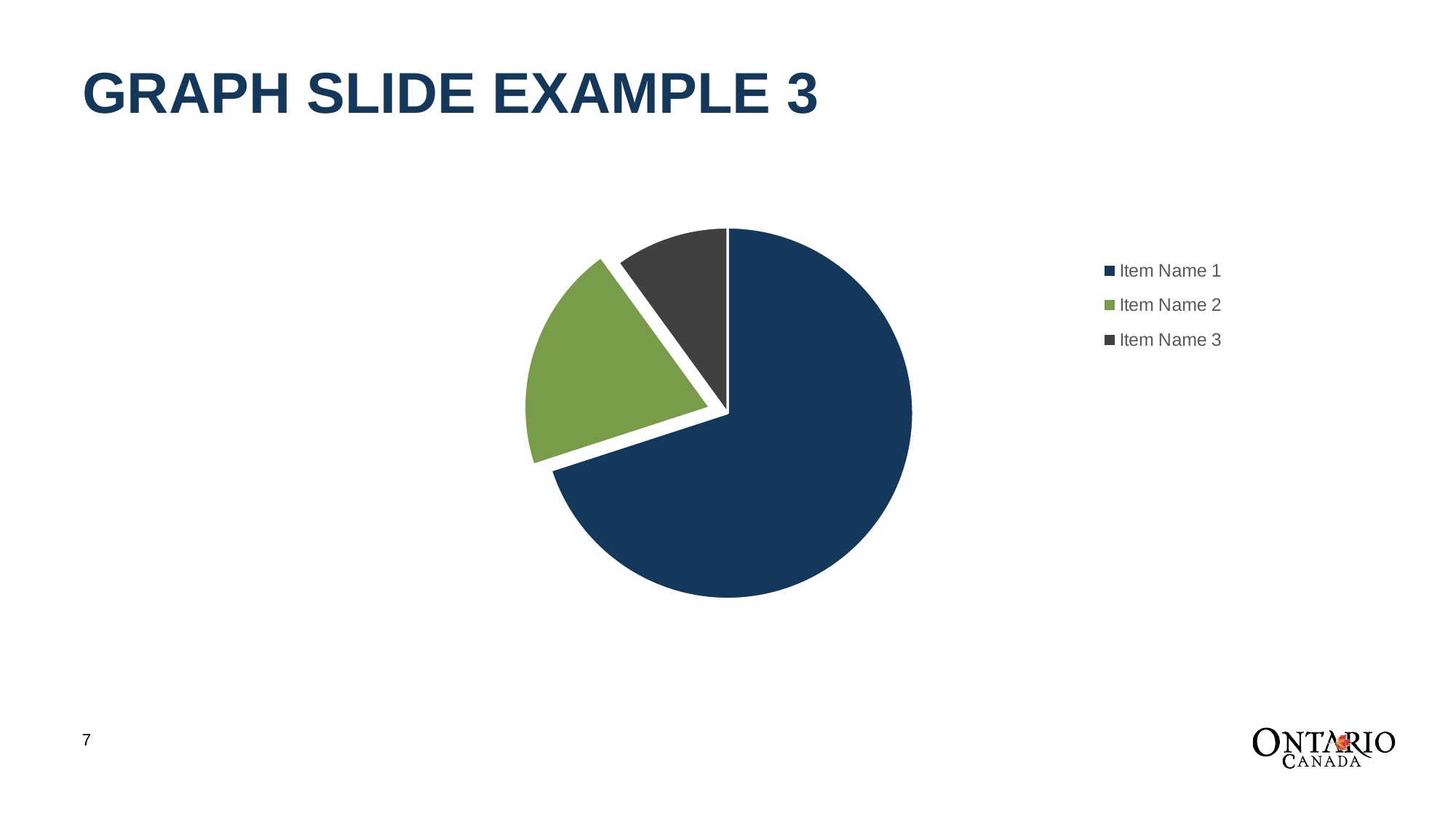
Which item has the smallest slice of the pie chart? Item Name 3 What is the title of the slide containing the pie chart? GRAPH SLIDE EXAMPLE 3 Which slice is larger, Item Name 2 or Item Name 3? Item Name 2 How many entries does the legend of the pie chart list? 3 Which slice is larger, Item Name 1 or Item Name 2? Item Name 1 Does Item Name 1 account for more or less than half of the pie chart? More How many slices does the pie chart have? 3 What colour is the slice for Item Name 2 in the pie chart? Green What kind of chart is shown on the slide? Pie chart Which item has the largest slice of the pie chart? Item Name 1